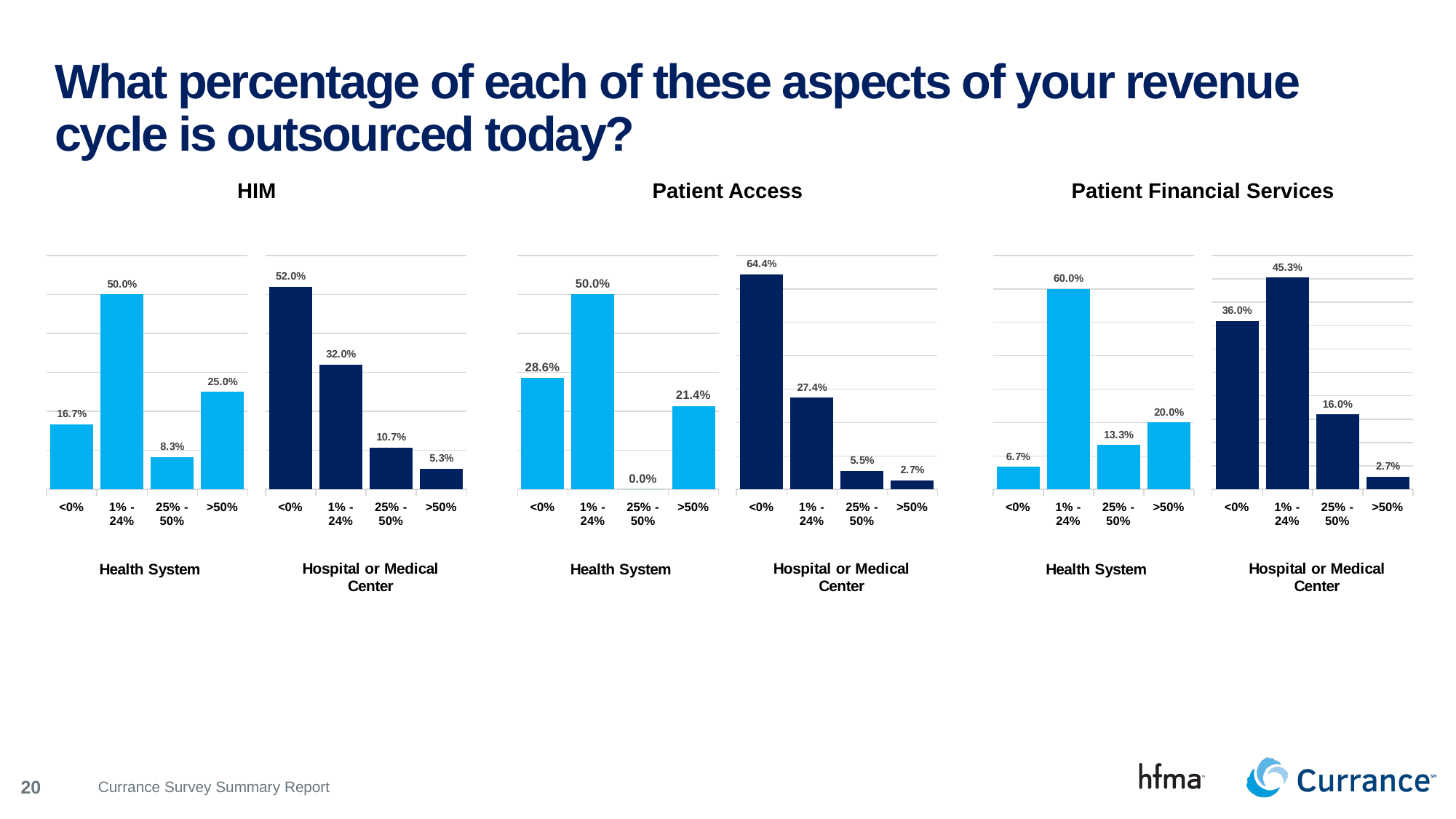
In the Patient Access chart, what is the value for the >50% category for Hospital or Medical Center? 2.7% In the Patient Financial Services chart, do the values for Hospital or Medical Center rise or fall from the 1% - 24% category to the >50% category? Fall In the Patient Access chart, what is the value for the 25% - 50% category for Health System? 0.0% In the HIM chart, what is the value for the 1% - 24% category for Health System? 50.0% How many categories are shown on the x axis of each Health System chart? 4 In the Patient Financial Services chart, which category has the lowest value for Health System? <0% What kind of chart is used on this slide? Bar chart In the HIM chart, what is the value for the <0% category for Hospital or Medical Center? 52.0% In the HIM chart, which is larger for Health System: the >50% value or the <0% value? >50% In the Patient Financial Services chart, what is the difference between the 1% - 24% and <0% values for Hospital or Medical Center? 9.3% What are the titles of the three chart groups on the slide? HIM, Patient Access, Patient Financial Services In the Patient Access chart, which category has the highest value for Hospital or Medical Center? <0%